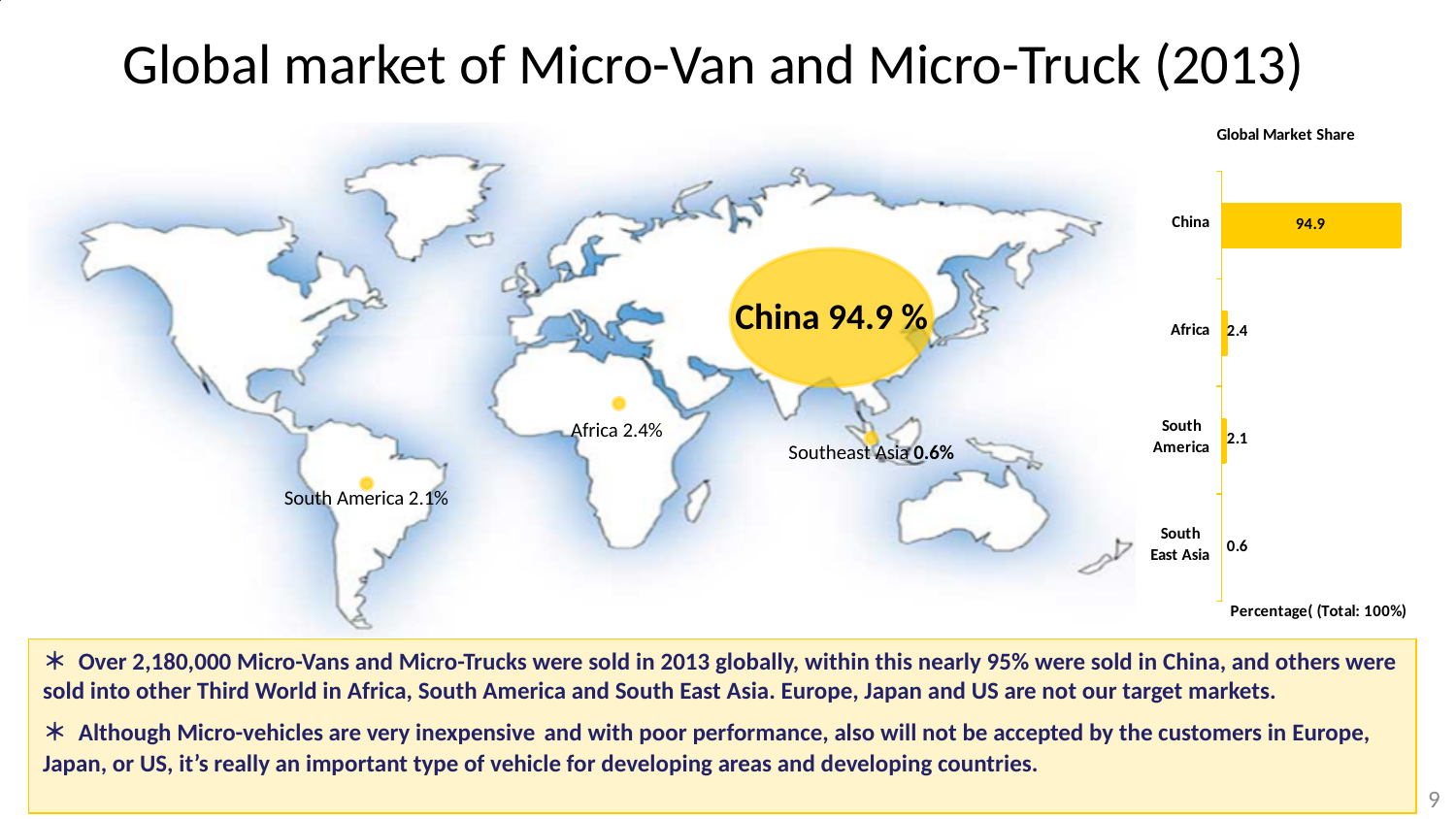
In the Global Market Share chart, which is larger, the value for Africa or the value for South America? Africa What is the value for China in the Global Market Share chart? 94.9 What is the difference between the values for China and Africa in the Global Market Share chart? 92.5 What is the difference between the values for Africa and South East Asia in the Global Market Share chart? 1.8 What kind of chart is the Global Market Share chart? Bar chart How many categories are shown in the Global Market Share chart? 4 What is the title of the chart on the right side of the slide? Global Market Share What is the value for South East Asia in the Global Market Share chart? 0.6 Which category has the highest value in the Global Market Share chart? China Which category has the lowest value in the Global Market Share chart? South East Asia What is the value for Africa in the Global Market Share chart? 2.4 What is the value for South America in the Global Market Share chart? 2.1